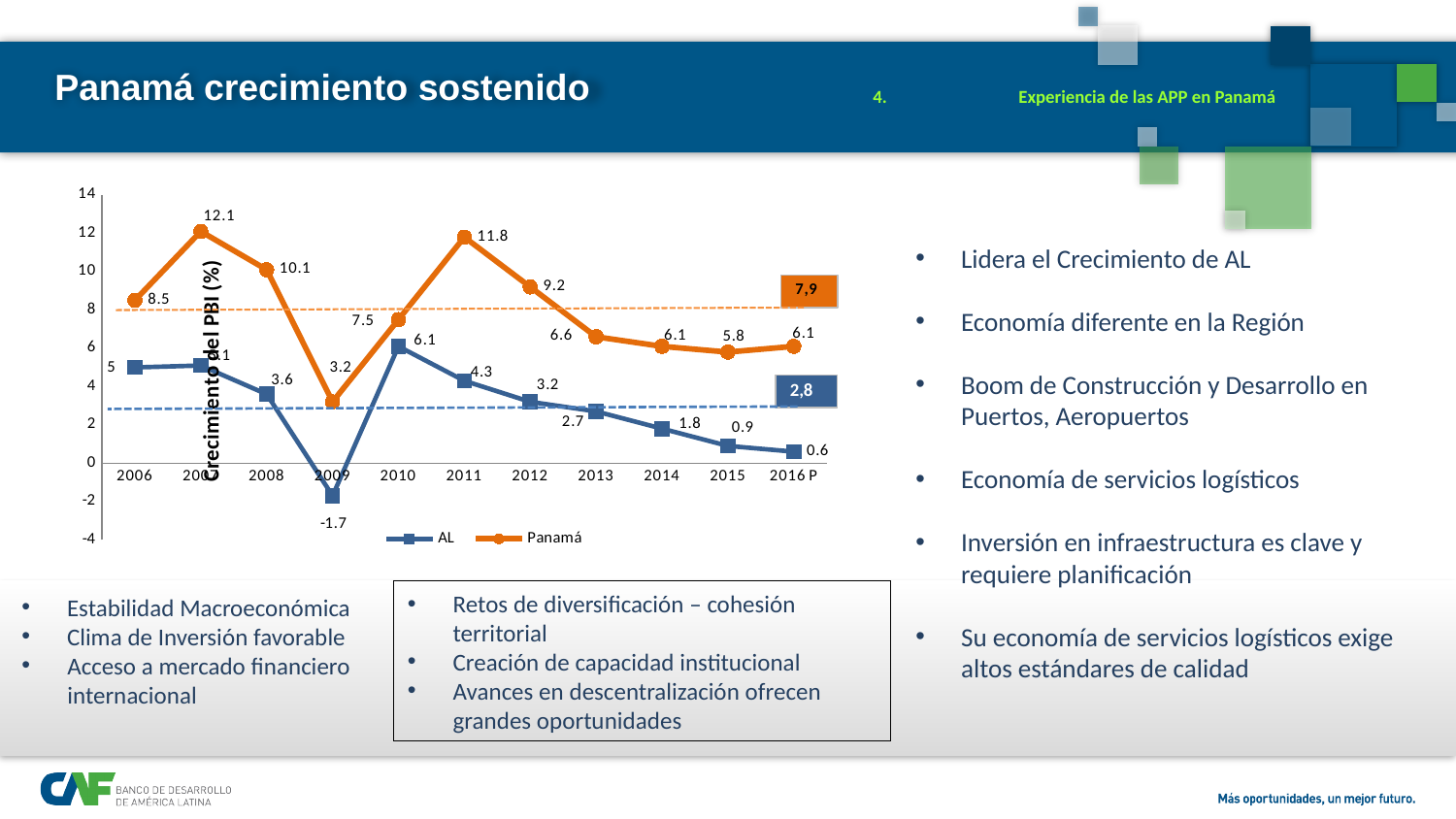
What is the difference between the Panamá and AL values in 2010? 1.4 In which year does the AL series reach its lowest value? 2009 Does the AL series rise or fall from 2010 to 2016 P? fall What is the value for Panamá in 2016 P? 6.1 What is the value for Panamá in 2011? 11.8 How many years are shown on the x axis of the chart? 11 In which year does the Panamá series reach its highest value? 2007 How many series does the chart legend list? 2 What is the value for AL in 2009? -1.7 What is the label on the vertical axis of the chart? Crecimiento del PBI (%) What type of chart is shown on the slide? line chart Which series has the larger value in 2013, AL or Panamá? Panamá